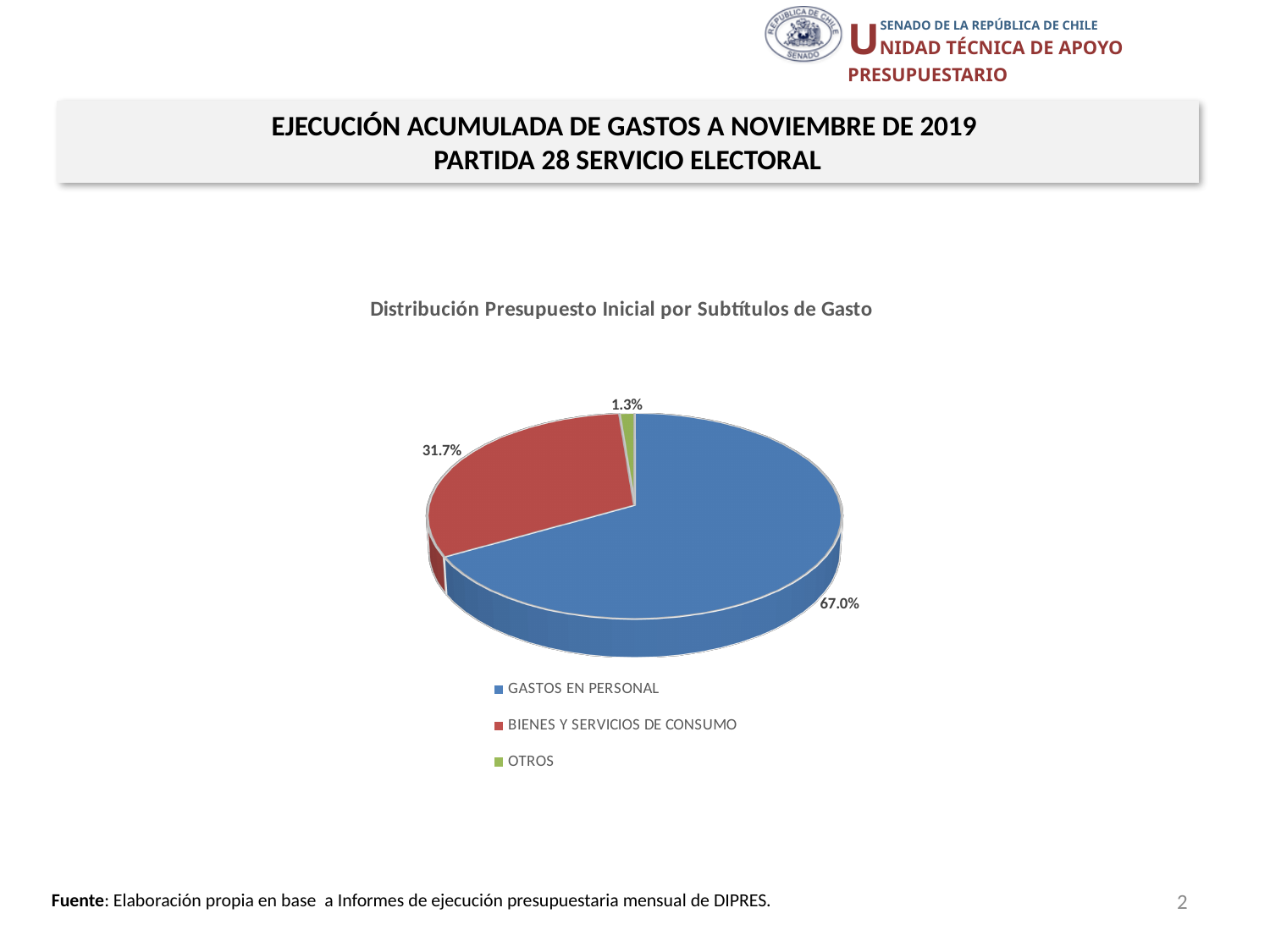
What share of the pie does OTROS represent? 1.3% Which category has the smallest share of the pie? OTROS What is the title of the chart? Distribución Presupuesto Inicial por Subtítulos de Gasto Which category has the largest share of the pie? GASTOS EN PERSONAL What share of the pie does GASTOS EN PERSONAL represent? 67.0% What kind of chart is shown on the slide? Pie chart What is the difference in percentage points between GASTOS EN PERSONAL and BIENES Y SERVICIOS DE CONSUMO? 35.3 Which is larger, the share for BIENES Y SERVICIOS DE CONSUMO or the share for OTROS? BIENES Y SERVICIOS DE CONSUMO What colour is the slice for BIENES Y SERVICIOS DE CONSUMO? Red What is the difference in percentage points between BIENES Y SERVICIOS DE CONSUMO and OTROS? 30.4 What share of the pie does BIENES Y SERVICIOS DE CONSUMO represent? 31.7% How many categories does the pie chart show? 3